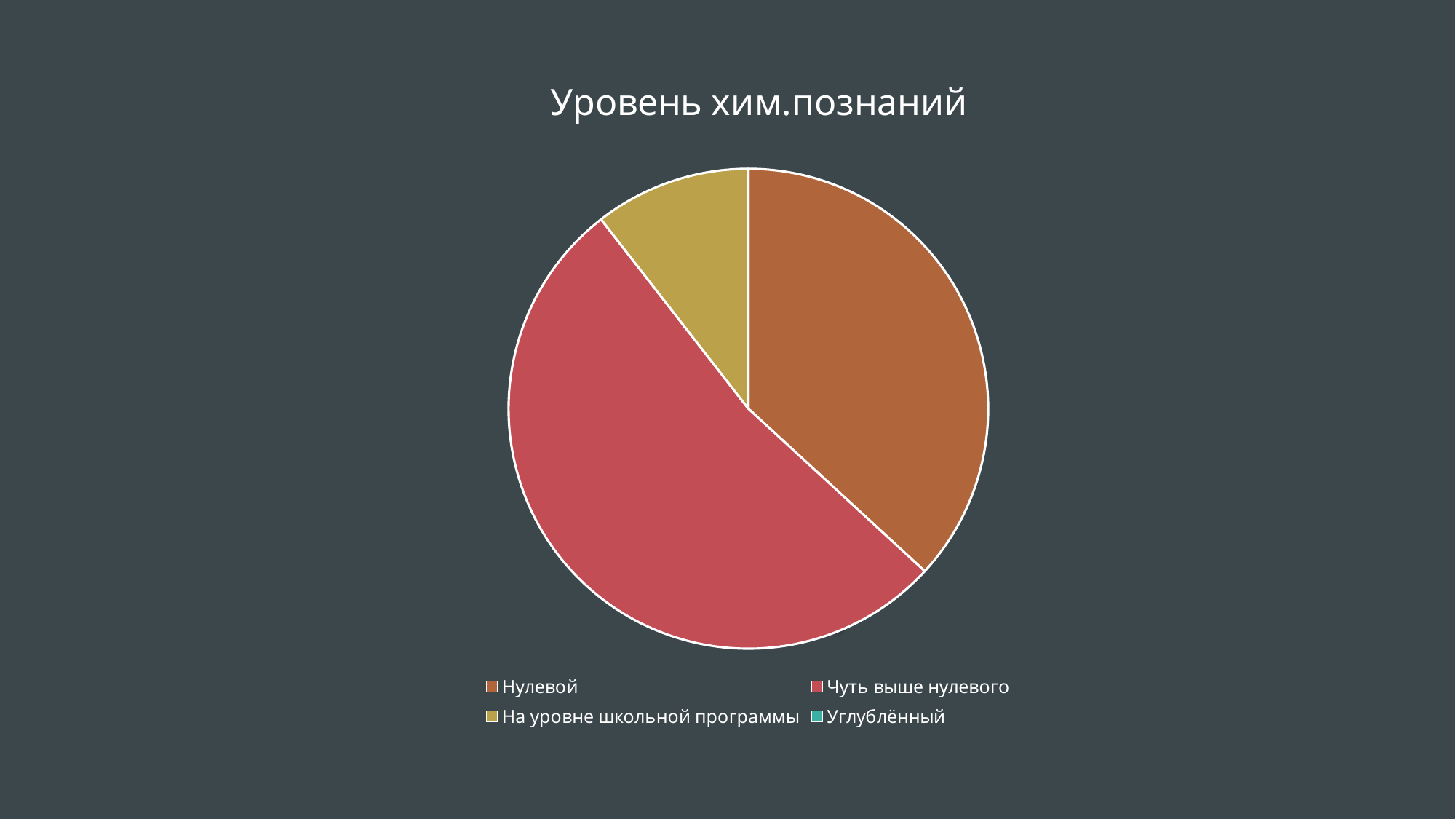
What is the title of the chart? Уровень хим.познаний Which slice is larger: Нулевой or На уровне школьной программы? Нулевой Which legend entry is shown in red? Чуть выше нулевого Which category has the largest slice of the pie? Чуть выше нулевого Of the slices visible in the pie, which category has the smallest one? На уровне школьной программы What kind of chart is shown on the slide? Pie chart Which slice is larger: Чуть выше нулевого or Нулевой? Чуть выше нулевого Which slice is larger: Чуть выше нулевого or На уровне школьной программы? Чуть выше нулевого How many categories does the legend of the pie chart list? 4